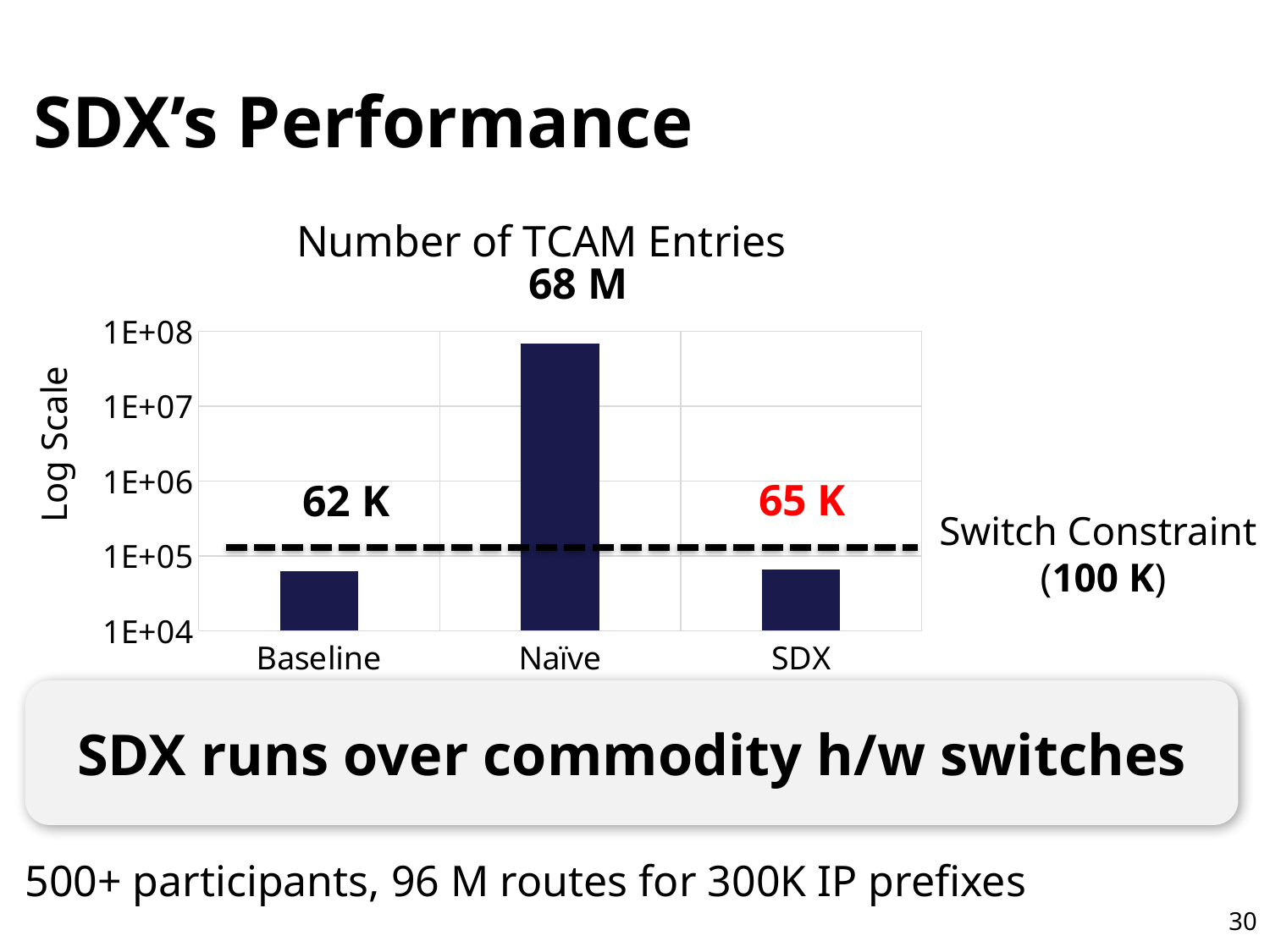
What is the number of TCAM entries for Baseline? 62 K What is the number of TCAM entries for SDX? 65 K Which has more TCAM entries, Naïve or SDX? Naïve What is the title of the chart? Number of TCAM Entries Which category has the highest number of TCAM entries? Naïve How many categories are shown on the x axis? 3 Is the value for Naïve greater or less than 1E+07? greater What value does the dashed Switch Constraint line represent? 100 K What kind of chart is shown on the slide? bar chart What is the number of TCAM entries for Naïve? 68 M Is the value for SDX greater or less than 1E+05? less Which category has the lowest number of TCAM entries? Baseline